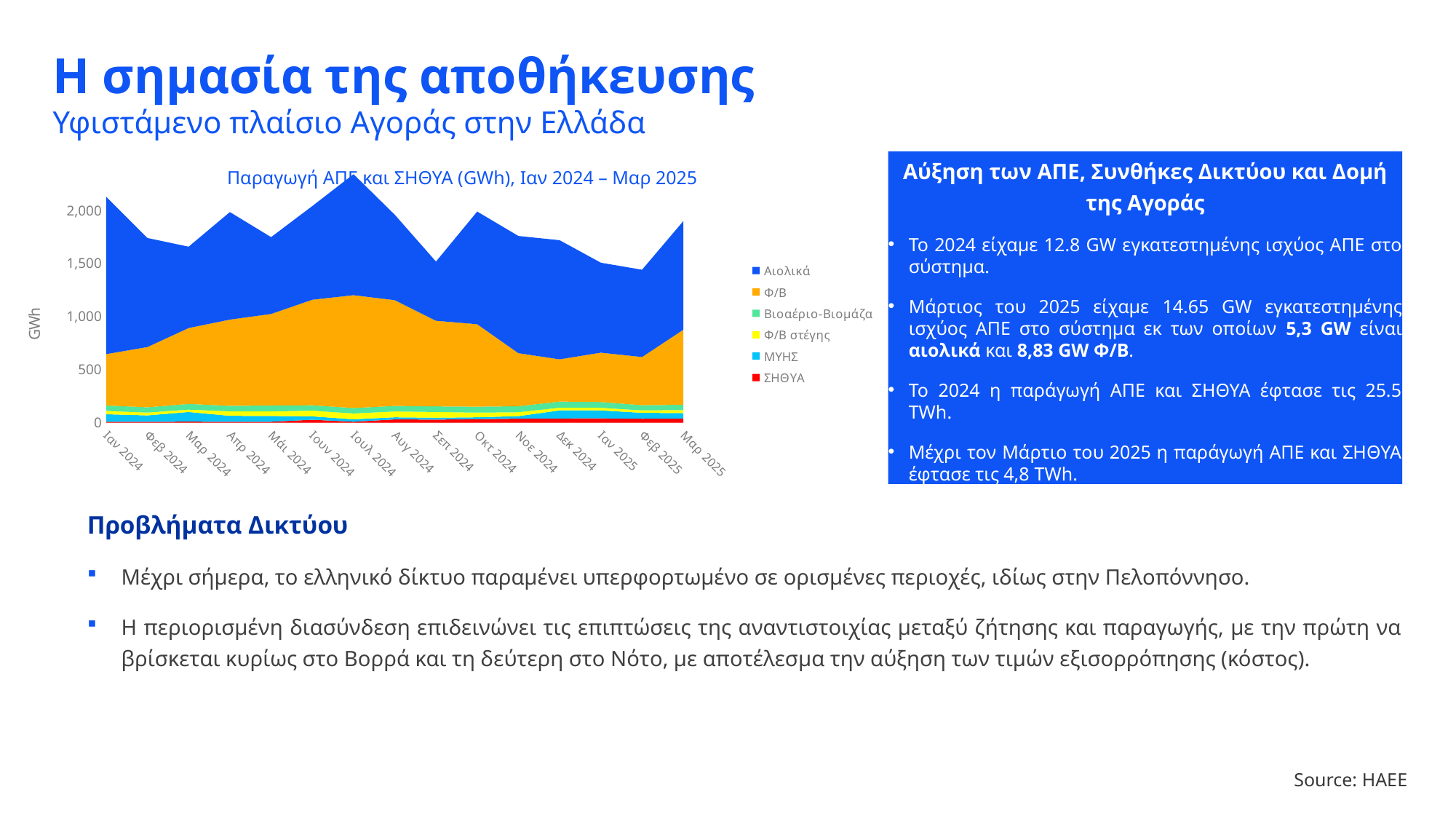
Is the total stacked value for Μαρ 2025 greater or less than 1,500? greater What is the title of the chart? Παραγωγή ΑΠΕ και ΣΗΘΥΑ (GWh), Ιαν 2024 – Μαρ 2025 What kind of chart is shown on the slide? Stacked area chart Which series is shown in red in the chart legend? ΣΗΘΥΑ How many series does the chart legend list? 6 Is the total stacked value for Φεβ 2025 greater or less than 1,500? less How many months are shown along the x axis of the chart? 15 Is the total stacked value for Δεκ 2024 greater or less than 1,500? greater Which month has the larger total stacked value, Ιαν 2024 or Φεβ 2025? Ιαν 2024 Does the total stacked value rise or fall from Ιουν 2024 to Σεπ 2024? fall